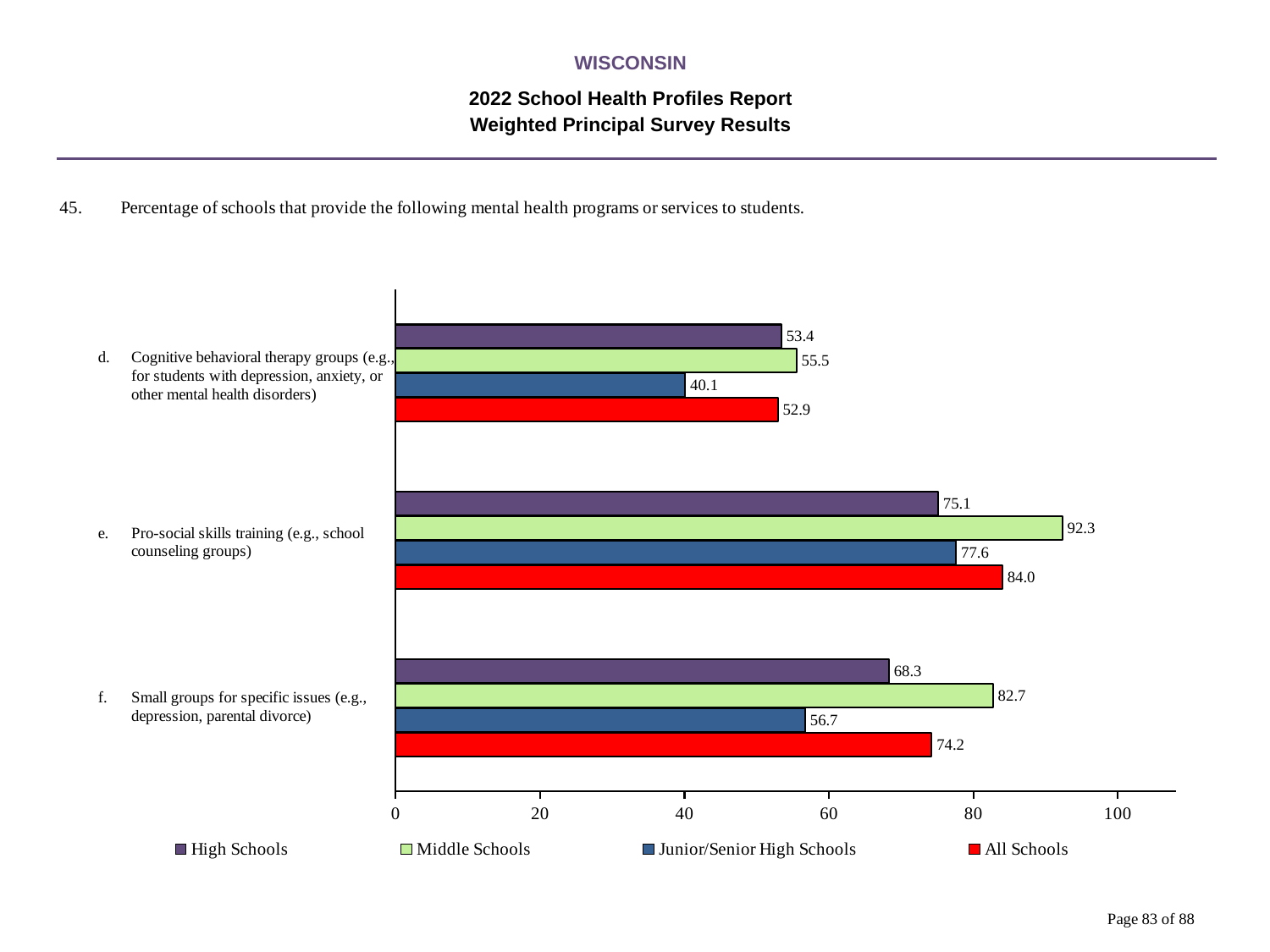
What is the All Schools value for small groups for specific issues (e.g., depression, parental divorce)? 74.2 What is the value for Junior/Senior High Schools for cognitive behavioral therapy groups? 40.1 Which is larger for small groups for specific issues: the High Schools value or the Junior/Senior High Schools value? High Schools Which colour represents All Schools in the legend? Red What is the difference between the Middle Schools and High Schools values for pro-social skills training? 17.2 How many mental health programs or services (categories) are shown on the chart? 3 Is the All Schools value for pro-social skills training greater or less than 80? greater Which school type has the highest value for small groups for specific issues? Middle Schools Which school type has the lowest value for cognitive behavioral therapy groups? Junior/Senior High Schools What kind of chart is shown on the slide? Bar chart What percentage of Middle Schools provide pro-social skills training (e.g., school counseling groups)? 92.3 How many series does the legend list? 4